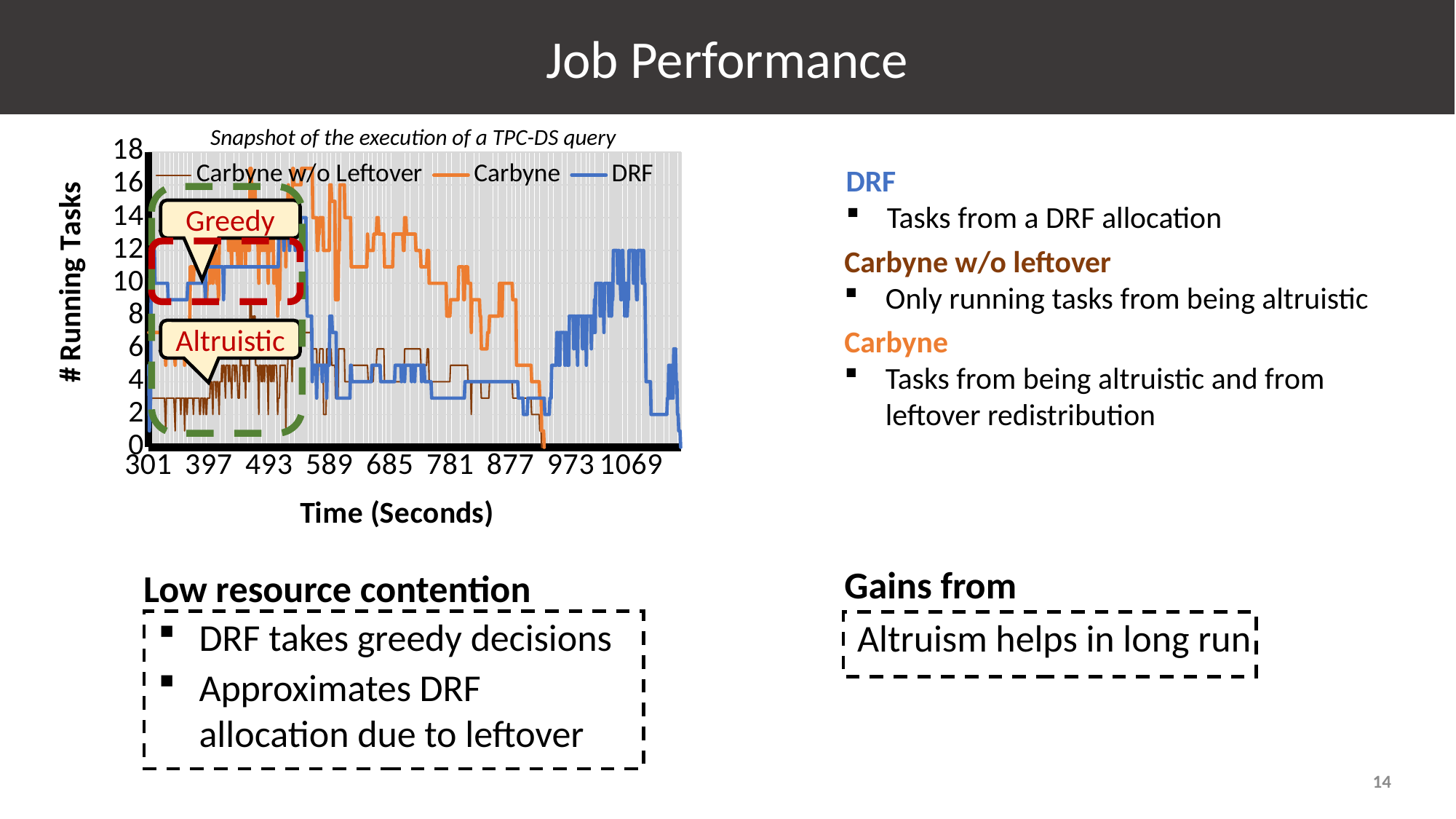
What are the three series named in the chart legend? Carbyne w/o Leftover, Carbyne, DRF What is the title printed above the chart? Snapshot of the execution of a TPC-DS query What is the label of the chart's x axis? Time (Seconds) Around time 397, which series has the higher value: Carbyne or Carbyne w/o Leftover? Carbyne What kind of chart is shown on the slide? line chart Is the value of the Carbyne w/o Leftover series at time 397 greater or less than 8? less Is the value of the DRF series at time 781 greater or less than 8? less How many series does the chart legend list? 3 Is the value of the Carbyne series at time 685 greater or less than 8? greater